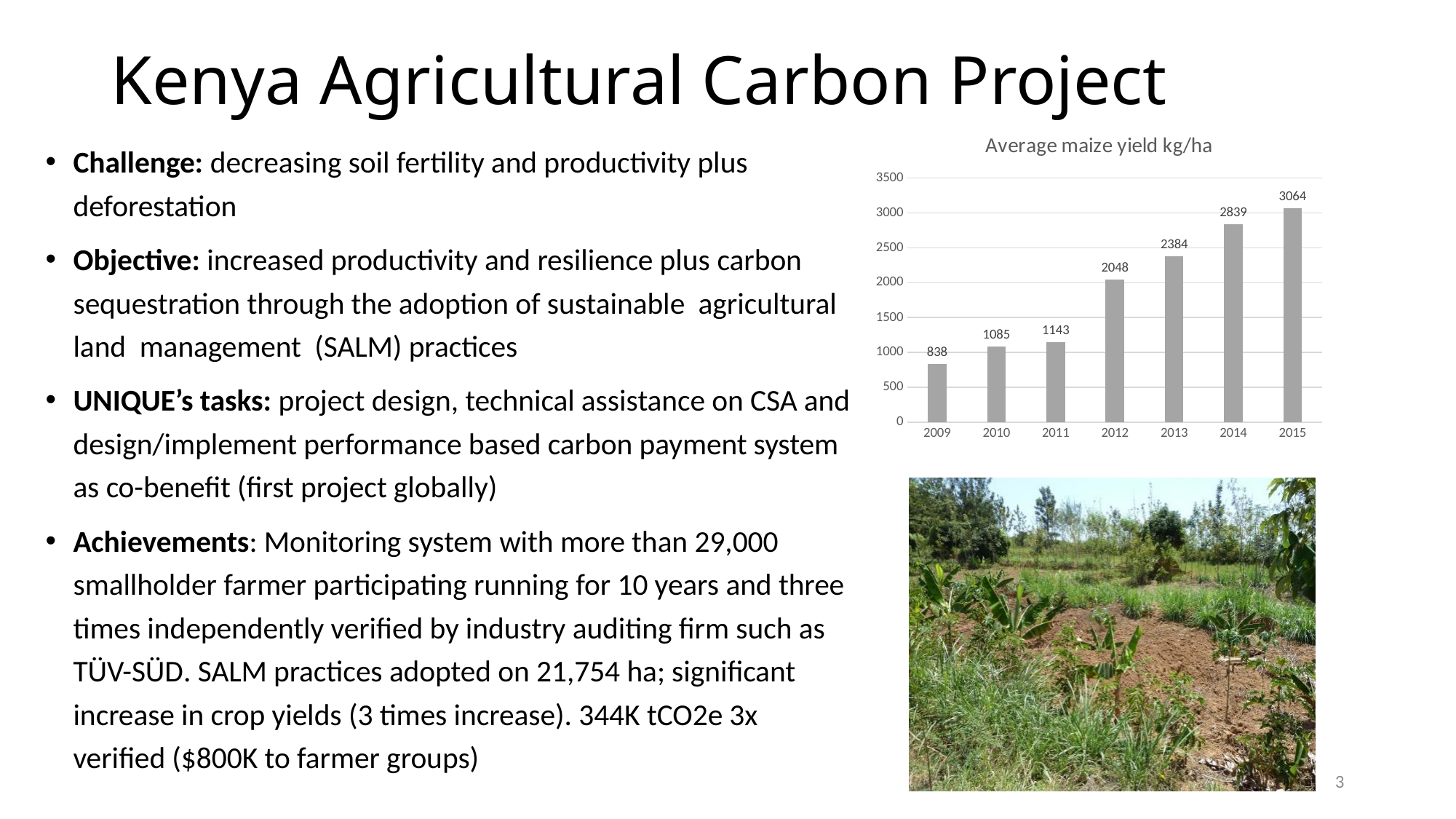
Do the average maize yield values rise or fall from 2009 to 2015? rise What is the average maize yield for 2009? 838 Which year has the highest average maize yield? 2015 Which year has the lowest average maize yield? 2009 What is the average maize yield for 2012? 2048 How many years are shown on the chart? 7 What is the title of the chart? Average maize yield kg/ha What is the difference in average maize yield between 2015 and 2009? 2226 What kind of chart is used to show average maize yield? bar chart Is the average maize yield for 2014 greater or less than 2500? greater Which year has a higher average maize yield, 2011 or 2013? 2013 What is the difference in average maize yield between 2010 and 2011? 58